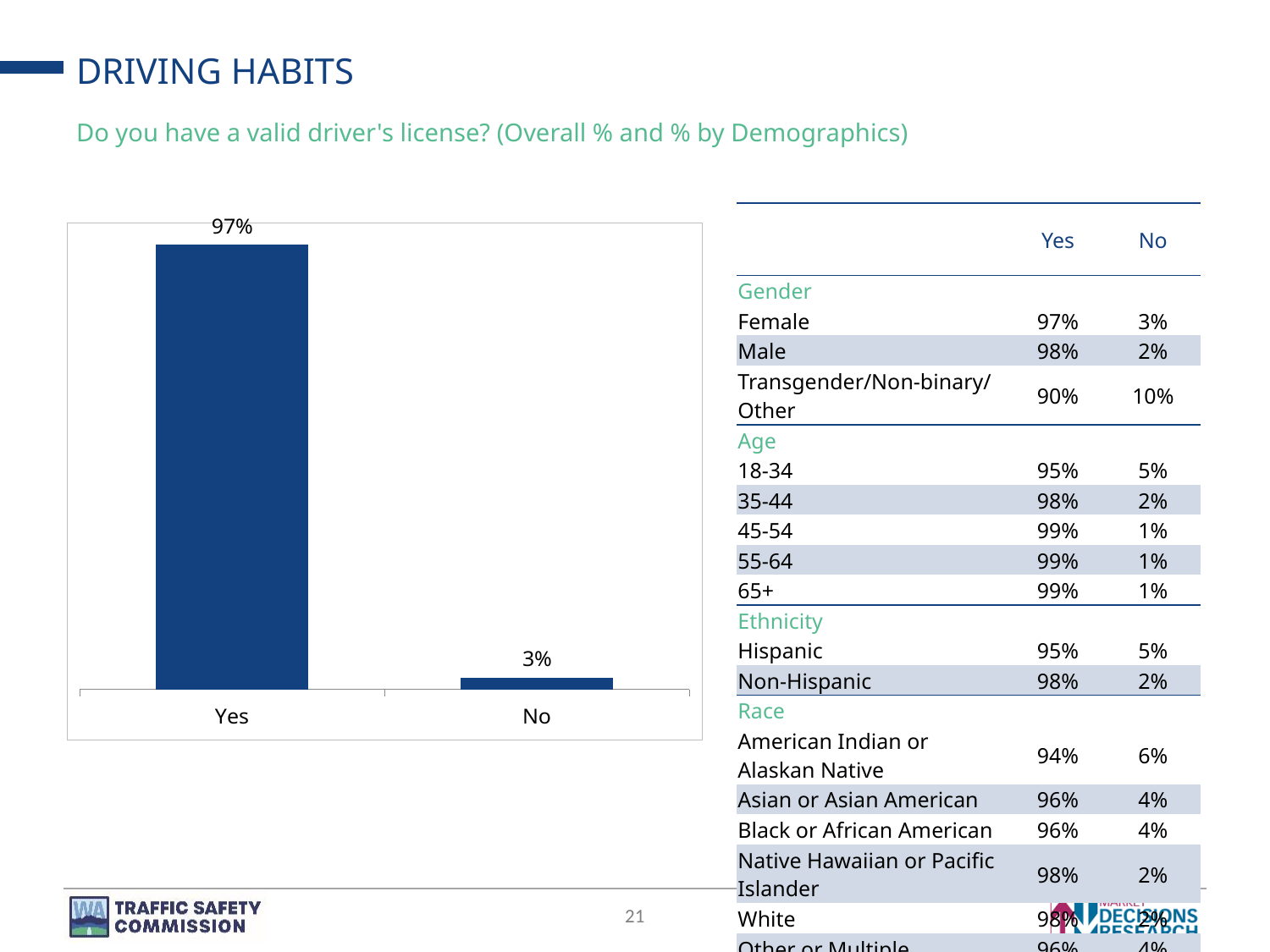
What kind of chart is shown on the slide? bar chart What is the difference between the Yes and No values in the bar chart? 94% What is the value for Yes in the bar chart? 97% Which is larger in the bar chart, the value for Yes or the value for No? Yes Which category has the lowest value in the bar chart? No What colour are the bars in the bar chart? dark blue What survey question does the bar chart on the slide show results for? Do you have a valid driver's license? What is the value for No in the bar chart? 3% How many categories are shown in the bar chart? 2 Do the values rise or fall from Yes to No along the x axis of the bar chart? fall Which category has the highest value in the bar chart? Yes